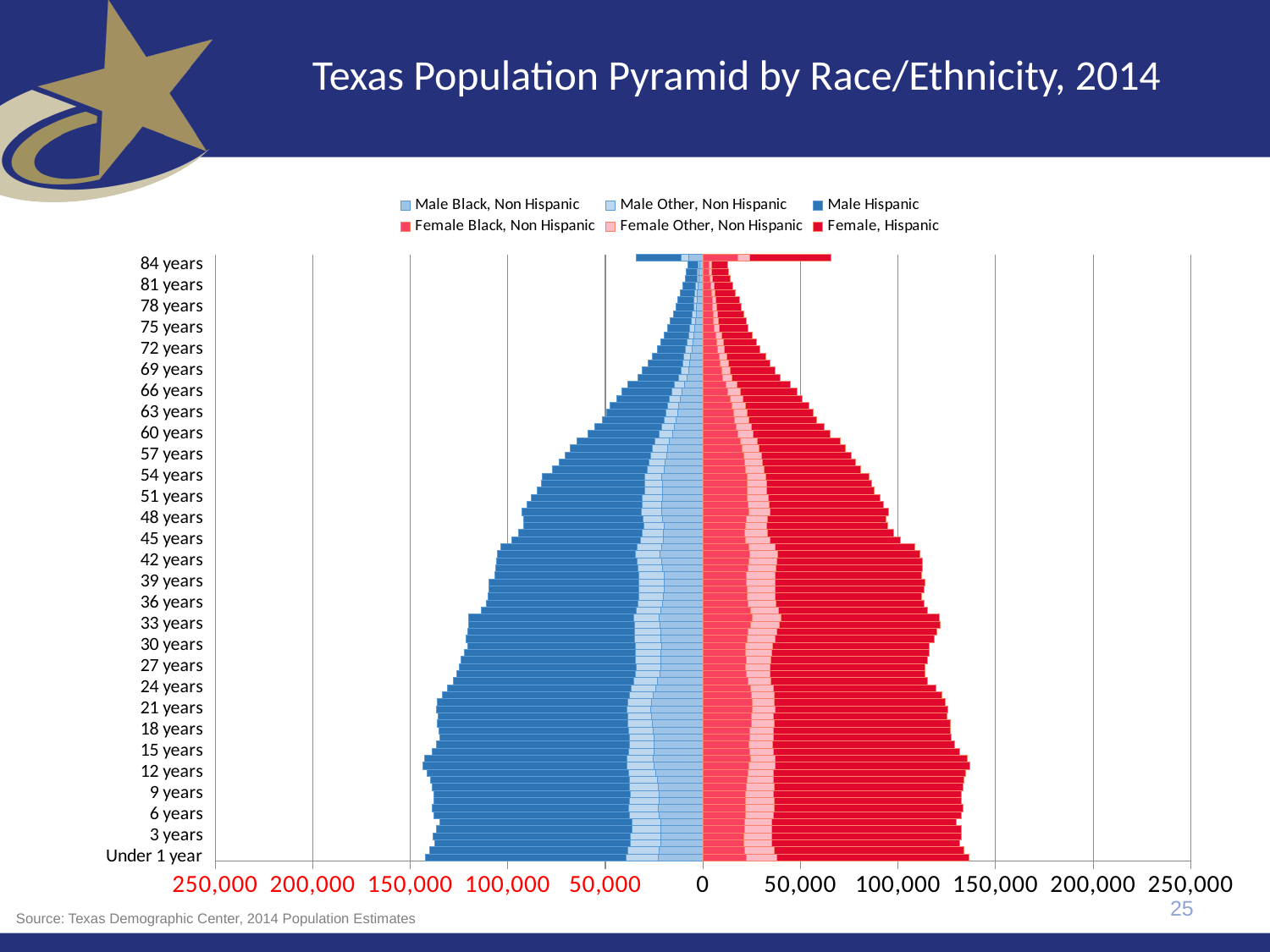
Is the total male bar for 60 years greater or less than 100,000? less Is the total female bar for Under 1 year greater or less than 200,000? less Moving from the youngest ages at the bottom to the oldest ages at the top, do the bars generally get longer or shorter? Shorter What is the title of the chart? Texas Population Pyramid by Race/Ethnicity, 2014 At Under 1 year, which male segment is larger, Male Hispanic or Male Black, Non Hispanic? Male Hispanic Is the total female bar for 84 years greater or less than 50,000? less How many series does the legend list? 6 At 84 years, which total bar is longer, the male bar or the female bar? Female Which legend entry is shown in dark blue? Male Hispanic What kind of chart is shown on the slide? Bar chart